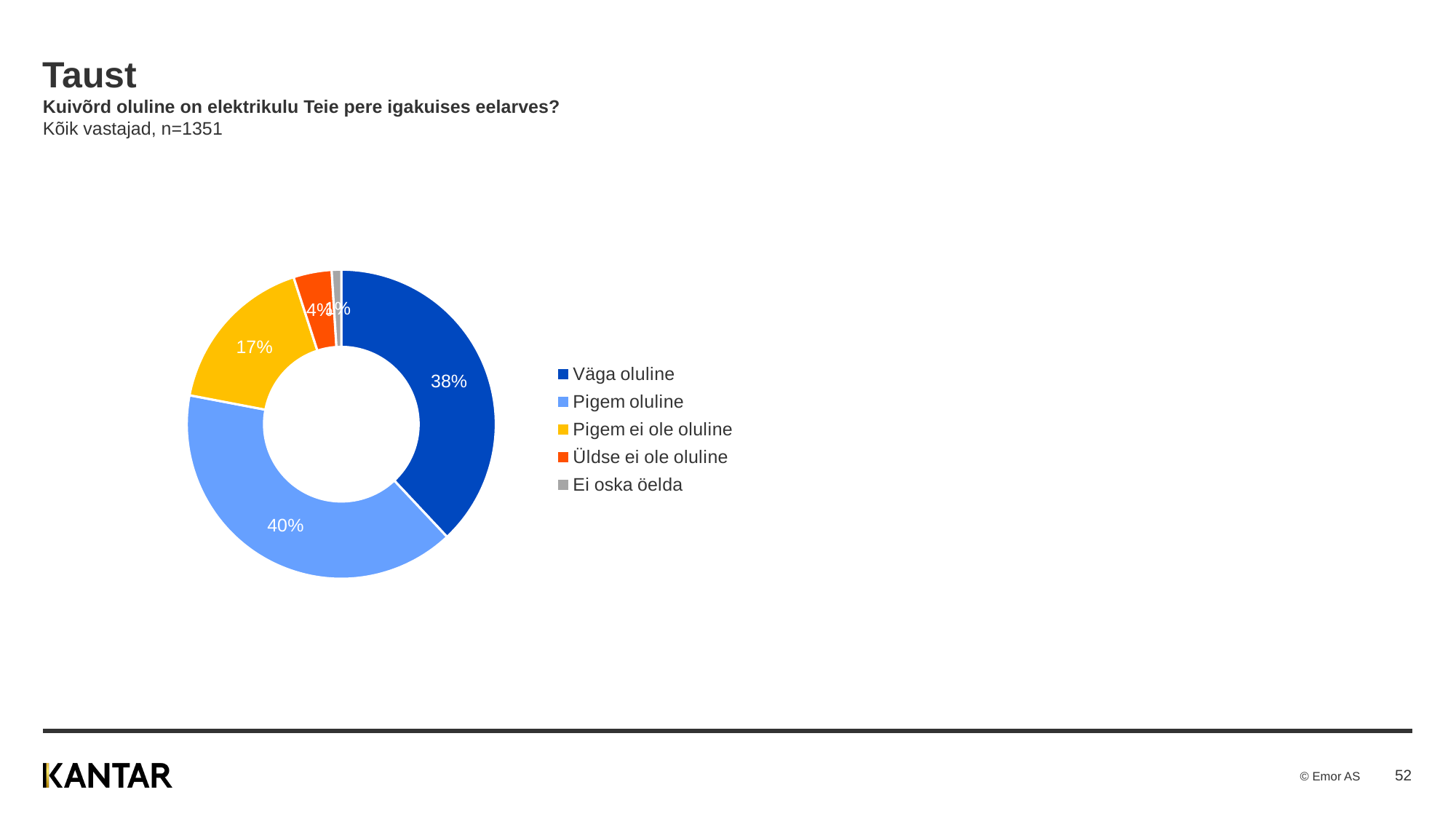
Which is larger, the share for "Väga oluline" or for "Pigem oluline"? Pigem oluline Which response category has the smallest share of the chart? Ei oska öelda What type of chart is shown on the slide? doughnut (pie) chart What is the difference between the shares of "Väga oluline" and "Üldse ei ole oluline"? 34% What share of the chart is "Pigem ei ole oluline"? 17% What is the difference in percentage points between "Pigem oluline" and "Pigem ei ole oluline"? 23% What colour represents "Pigem ei ole oluline" in the legend? yellow What percentage is shown for "Üldse ei ole oluline"? 4% What percentage of respondents answered "Pigem oluline"? 40% How many response categories does the chart show? 5 What percentage of respondents answered "Väga oluline"? 38% Which response category has the largest share of the chart? Pigem oluline